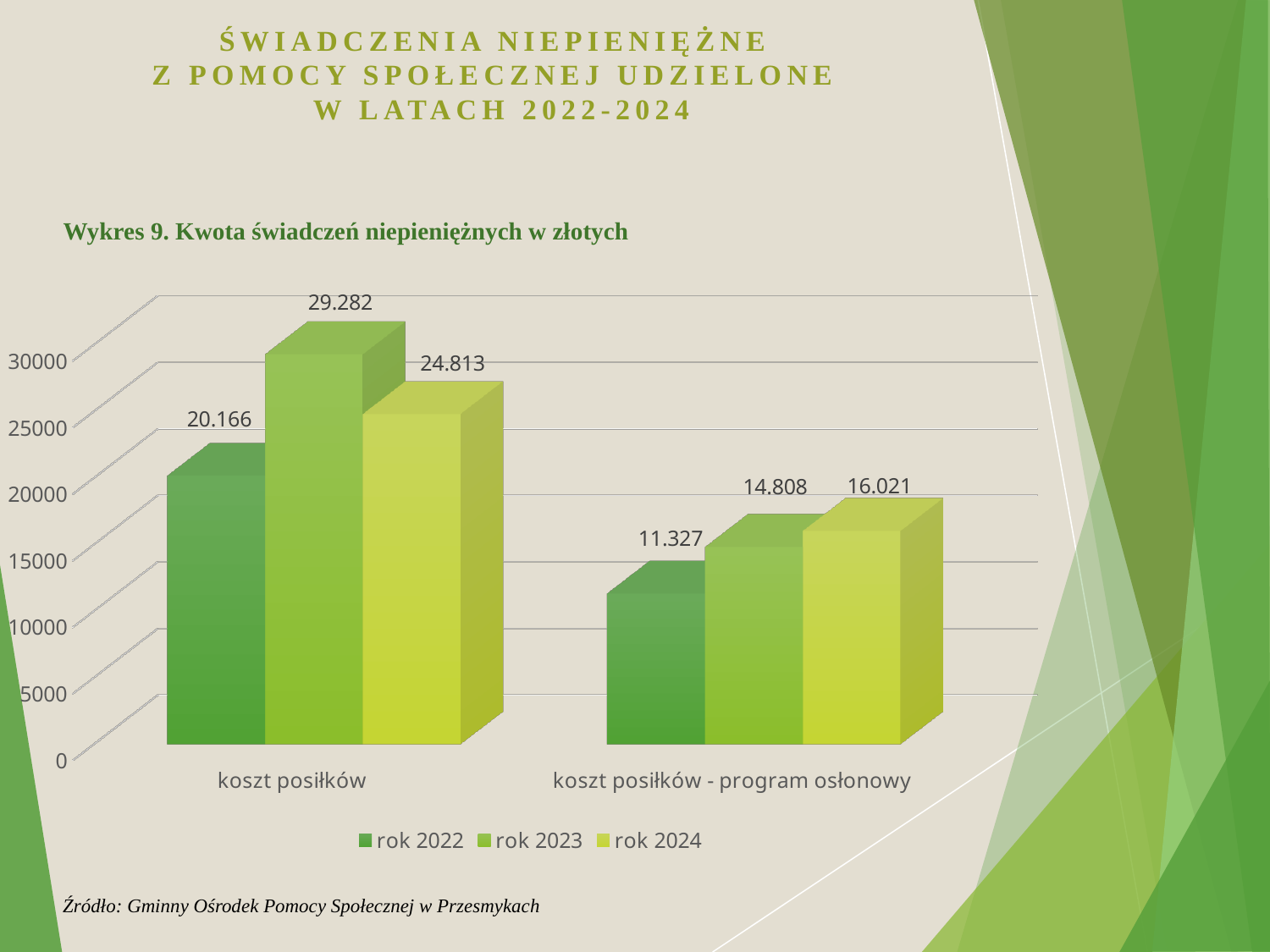
What is the value for rok 2022 in the koszt posiłków - program osłonowy category? 11.327 What is the value for rok 2023 in the koszt posiłków category? 29.282 How many categories are shown on the x axis? 2 How many series does the legend list? 3 What is the difference between the rok 2024 and rok 2023 values in the koszt posiłków - program osłonowy category? 1.213 Which is larger: the rok 2024 value for koszt posiłków or the rok 2024 value for koszt posiłków - program osłonowy? koszt posiłków Which year has the highest value in the koszt posiłków category? rok 2023 What is the difference between the rok 2023 and rok 2022 values in the koszt posiłków category? 9.116 What is the value for rok 2024 in the koszt posiłków category? 24.813 What kind of chart is shown on the slide? bar chart What is the title of the chart? Wykres 9. Kwota świadczeń niepieniężnych w złotych Which year has the lowest value in the koszt posiłków - program osłonowy category? rok 2022